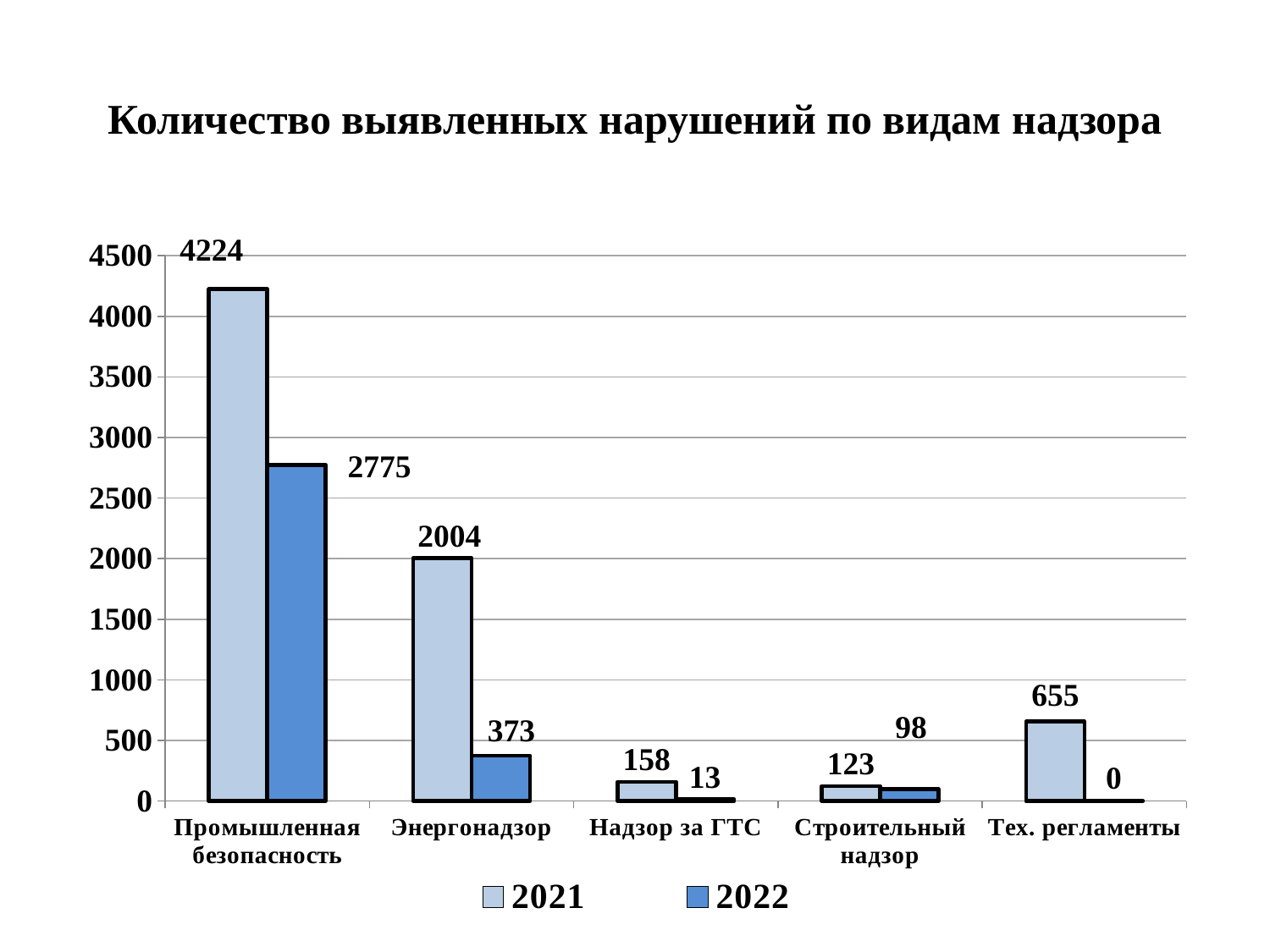
What kind of chart is this? Bar chart What is the difference between the 2021 and 2022 values for Промышленная безопасность? 1449 What is the title of the chart? Количество выявленных нарушений по видам надзора What is the difference between the 2021 and 2022 values for Энергонадзор? 1631 Which is larger: the 2021 value for Строительный надзор or the 2021 value for Надзор за ГТС? Надзор за ГТС Which category has the highest value in 2021? Промышленная безопасность What is the value for Энергонадзор in 2022? 373 What is the value for Промышленная безопасность in 2021? 4224 Which category has the lowest value in 2022? Тех. регламенты How many categories are shown on the x axis? 5 How many series does the legend list? 2 What is the value for Тех. регламенты in 2022? 0